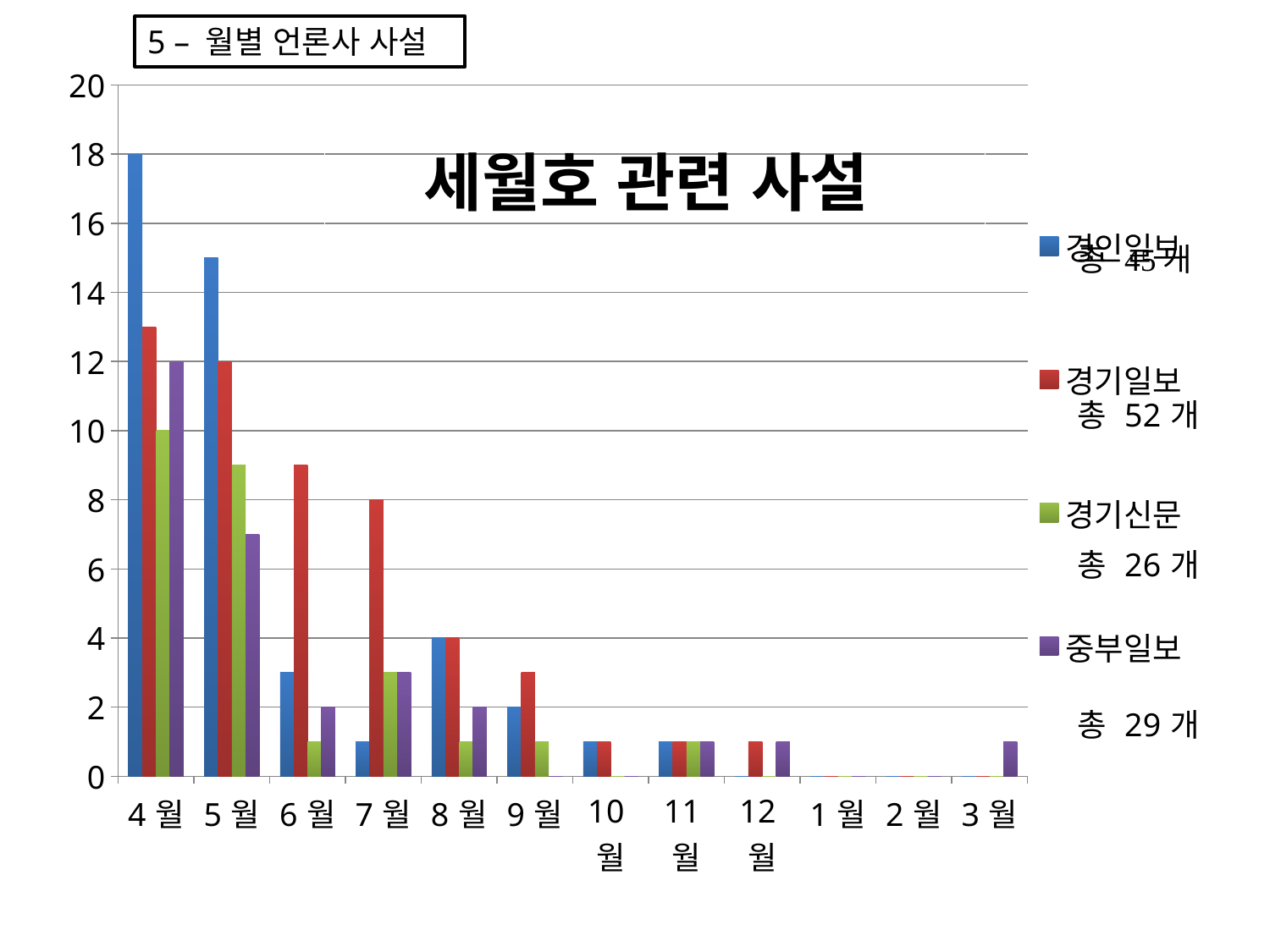
How many series does the legend list? 4 What is the difference between the 경인일보 and 경기신문 values in 4월? 8 Is the value for 경인일보 in 5월 greater or less than 14? greater What type of chart is shown on the slide? bar chart Which is larger in 4월: the value for 경인일보 or the value for 중부일보? 경인일보 Do the 경인일보 values rise or fall from 4월 to 9월? fall What is the value for 경기일보 in 7월? 8 What is the value for 경기신문 in 4월? 10 Which series has the highest bar in the chart, and in which month? 경인일보, 4월 What is the value for 경인일보 in 4월? 18 How many months are shown on the x axis? 12 What is the title of the chart? 세월호 관련 사설